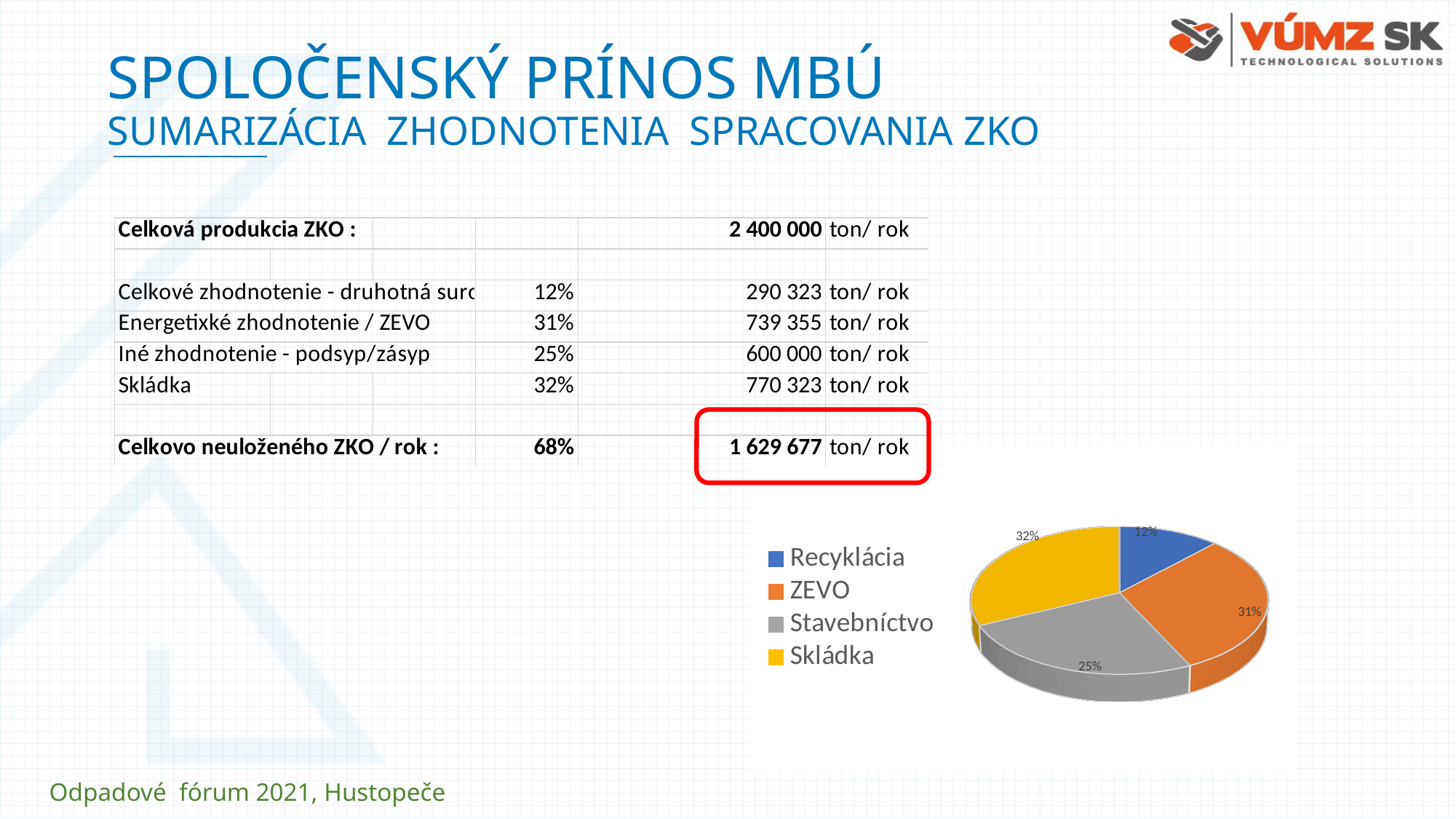
How many slices does the pie chart have? 4 In the pie chart, which is larger: ZEVO or Stavebníctvo? ZEVO Which slice of the pie chart is the smallest? Recyklácia What share of the pie chart does Recyklácia take? 12% What share of the pie chart does Stavebníctvo take? 25% What kind of chart is shown on the slide? pie chart What share of the pie chart does ZEVO take? 31% Which slice of the pie chart is the largest? Skládka What colour is the Skládka slice in the pie chart? yellow How many entries does the pie chart's legend list? 4 In the pie chart, what is the difference between the Skládka share and the Recyklácia share? 20%